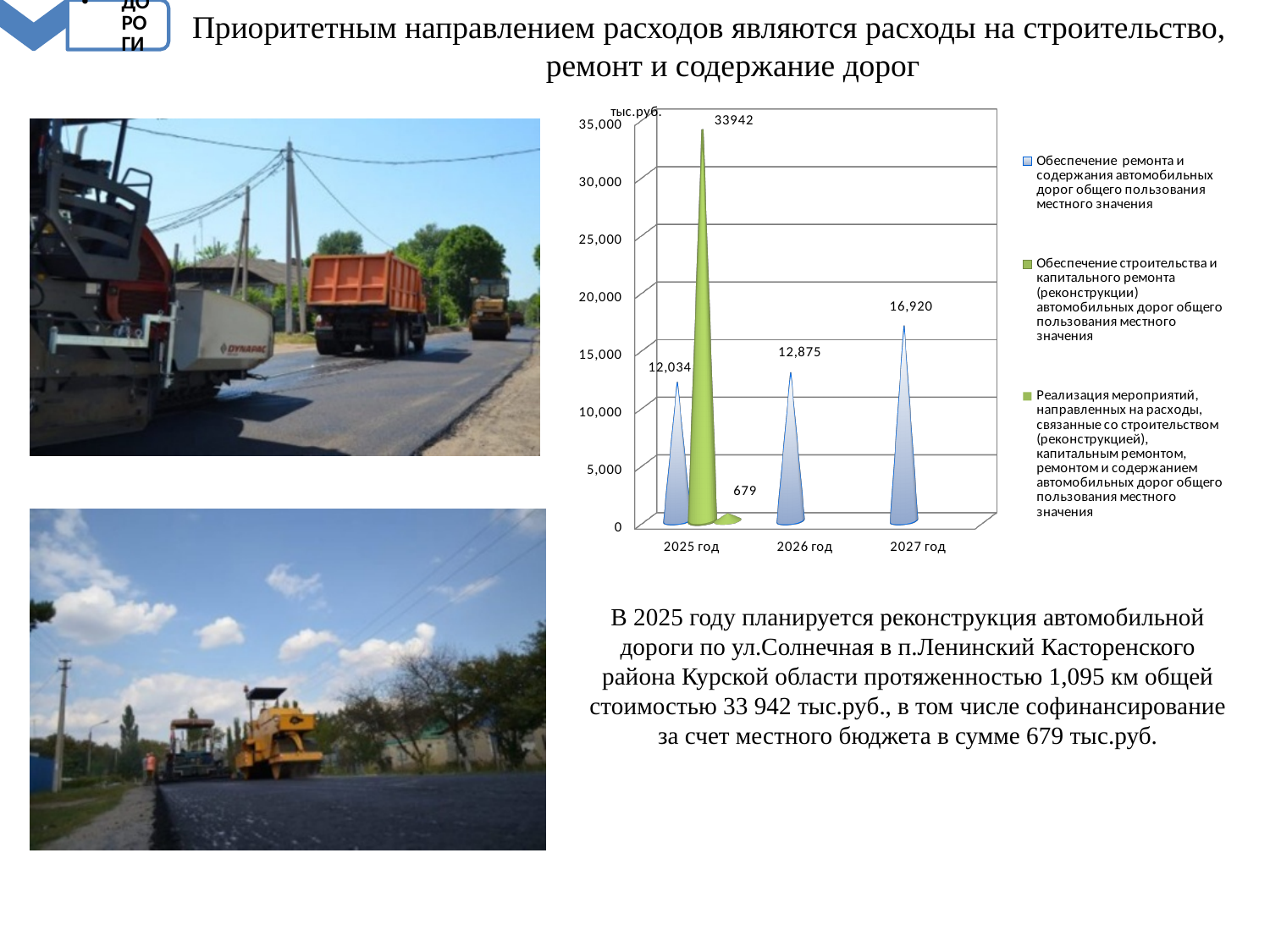
Which is larger: the 2025 год value for 'Обеспечение строительства и капитального ремонта' or the 2025 год value for 'Обеспечение ремонта и содержания'? Обеспечение строительства и капитального ремонта What is the value for 2025 год for the series 'Обеспечение ремонта и содержания автомобильных дорог общего пользования местного значения'? 12,034 What unit is shown on the vertical axis of the chart? тыс.руб. What is the value for 2025 год for the series 'Обеспечение строительства и капитального ремонта (реконструкции) автомобильных дорог общего пользования местного значения'? 33942 Which year has the highest value for the series 'Обеспечение ремонта и содержания автомобильных дорог общего пользования местного значения'? 2027 год What is the value for 2026 год for the series 'Обеспечение ремонта и содержания автомобильных дорог общего пользования местного значения'? 12,875 What is the value for 2025 год for the series 'Реализация мероприятий, направленных на расходы, связанные со строительством (реконструкцией), капитальным ремонтом, ремонтом и содержанием автомобильных дорог общего пользования местного значения'? 679 What is the value for 2027 год for the series 'Обеспечение ремонта и содержания автомобильных дорог общего пользования местного значения'? 16,920 Does the value for the series 'Обеспечение ремонта и содержания автомобильных дорог общего пользования местного значения' rise or fall from 2025 год to 2027 год? rise How many year categories are shown on the x axis? 3 How many series does the legend list? 3 What is the difference between the 2027 год and 2026 год values for the series 'Обеспечение ремонта и содержания автомобильных дорог общего пользования местного значения'? 4,045